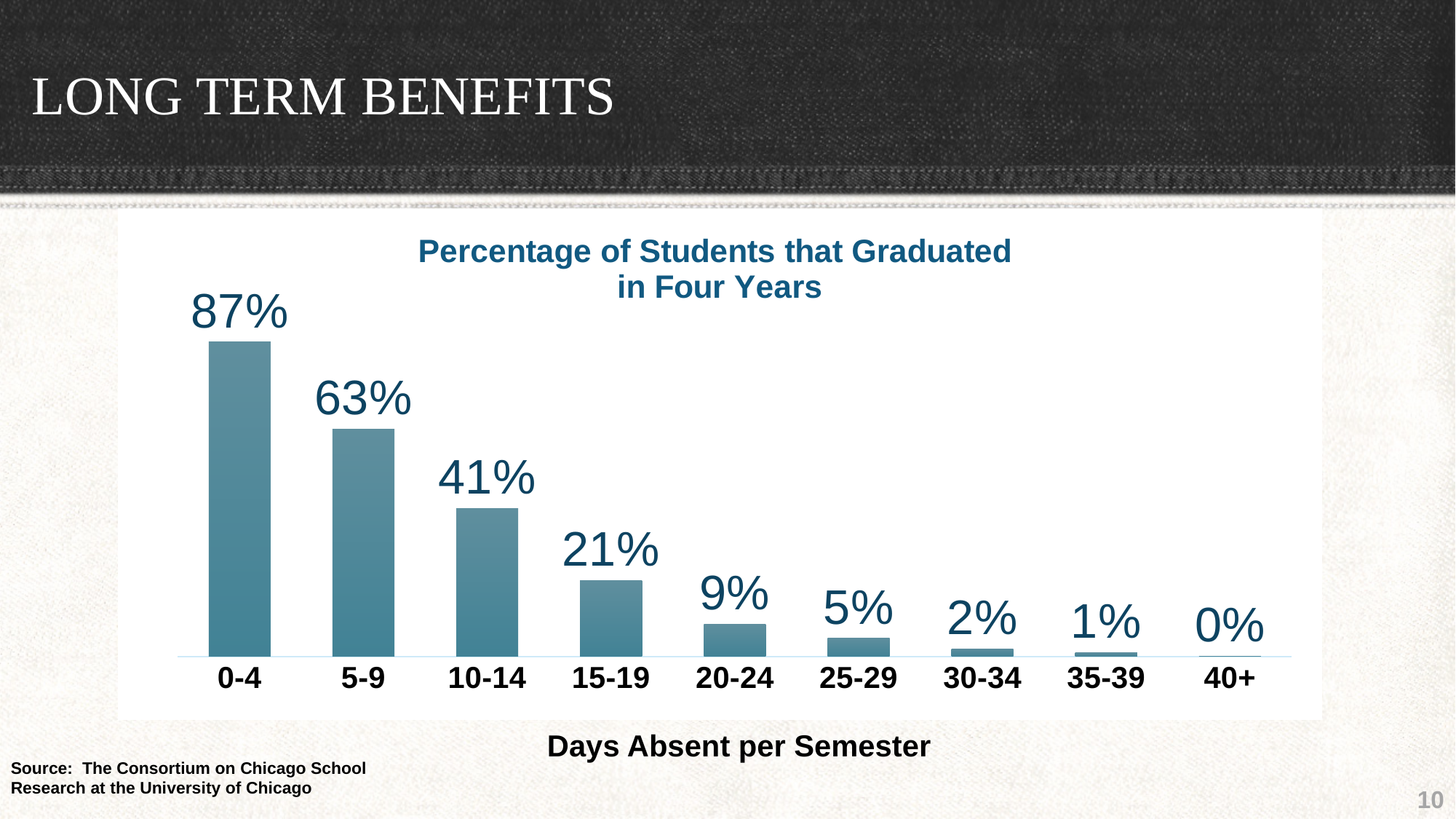
Which days-absent category has the lowest percentage of students graduating in four years? 40+ Do the values rise or fall as days absent per semester increase along the x axis? Fall What kind of chart is shown on the slide? Bar chart What percentage of students with 0-4 days absent per semester graduated in four years? 87% What is the value for the 10-14 days absent category? 41% What percentage is shown for the 20-24 days absent category? 9% Which days-absent category has the highest percentage of students graduating in four years? 0-4 Which has a higher value, the 5-9 category or the 10-14 category? 5-9 What is the value for the 40+ days absent category? 0% What is the difference between the values for the 15-19 and 25-29 categories? 16% How many days-absent categories are shown on the x axis? 9 What is the difference between the values for the 0-4 and 5-9 categories? 24%